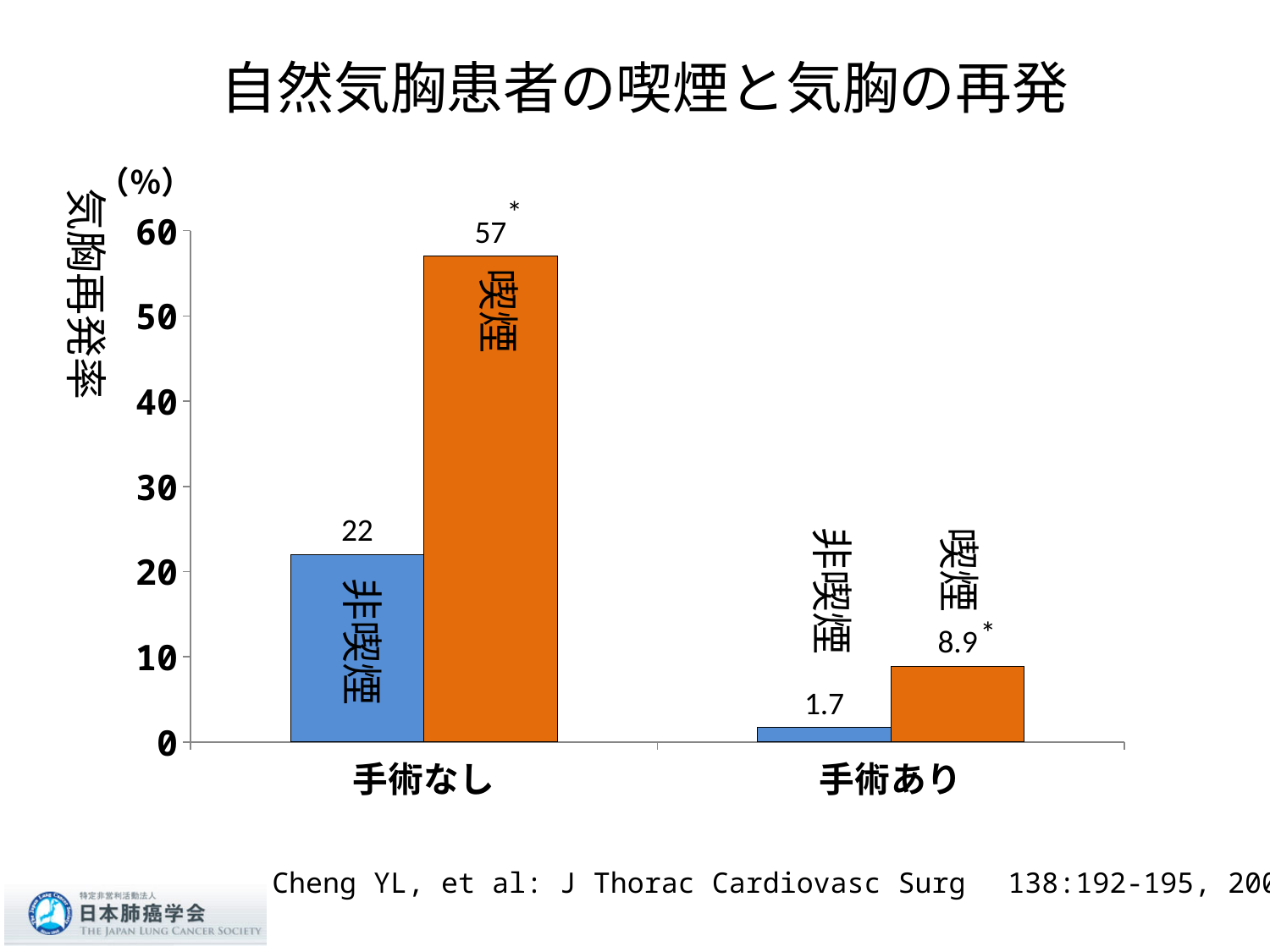
What is the pneumothorax recurrence rate for 非喫煙 (non-smokers) in the 手術あり (surgery) group? 1.7 What is the difference in recurrence rate between 喫煙 and 非喫煙 in the 手術あり group? 7.2 What is the pneumothorax recurrence rate for 喫煙 (smokers) in the 手術なし (no surgery) group? 57 Which bar shows the lowest recurrence rate? 非喫煙 in 手術あり How many categories are shown on the x axis? 2 What is the pneumothorax recurrence rate for 非喫煙 (non-smokers) in the 手術なし (no surgery) group? 22 What kind of chart is shown on the slide? Bar chart What is the difference in recurrence rate between 喫煙 and 非喫煙 in the 手術なし group? 35 Which bar shows the highest recurrence rate? 喫煙 in 手術なし What is the title of the chart on the slide? 自然気胸患者の喫煙と気胸の再発 In the 手術あり group, which has the higher recurrence rate, 喫煙 or 非喫煙? 喫煙 What is the pneumothorax recurrence rate for 喫煙 (smokers) in the 手術あり (surgery) group? 8.9